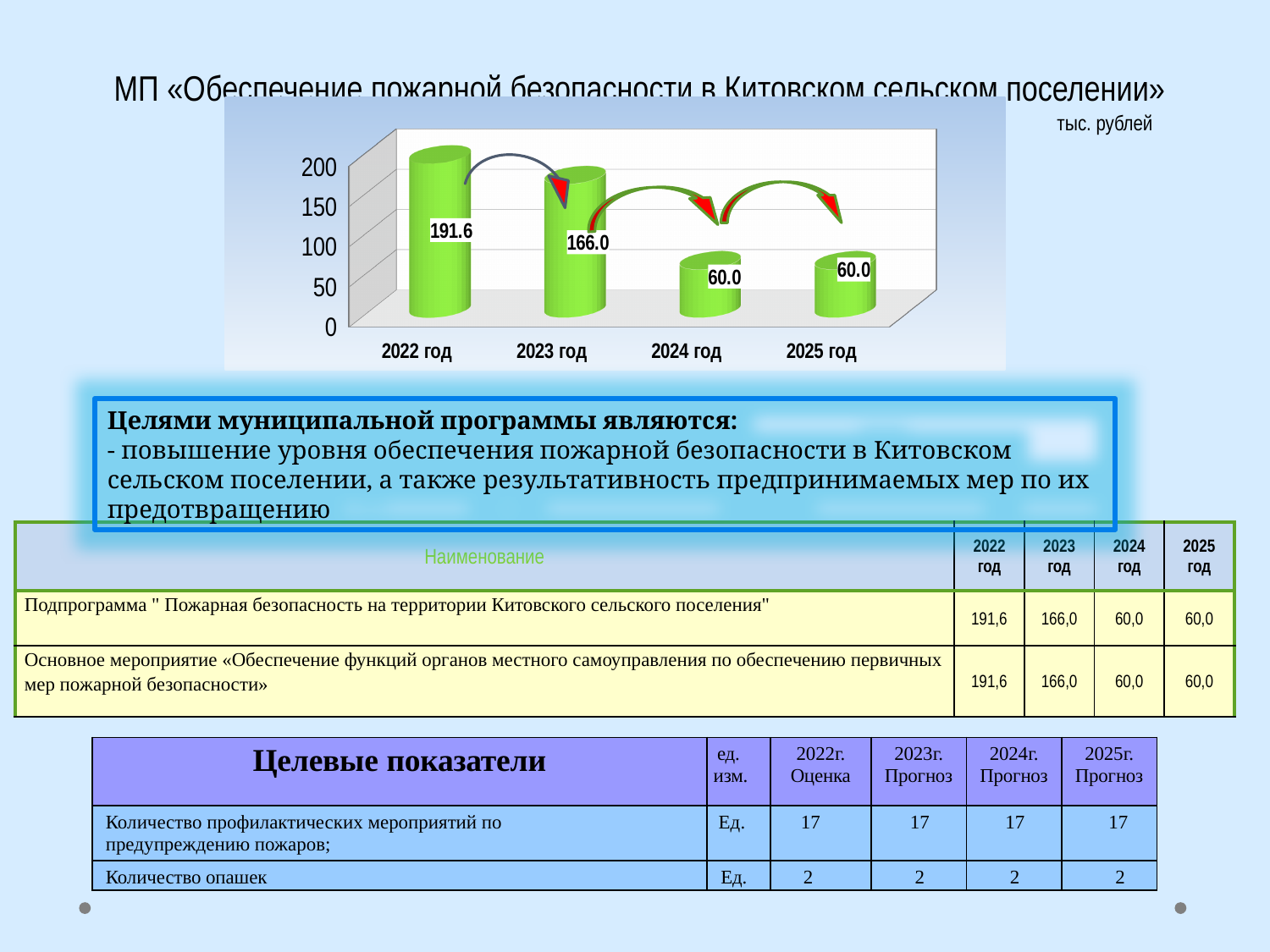
Do the values rise or fall from 2022 год to 2024 год? fall Which year has the highest value on the chart? 2022 год Which is larger, the value for 2022 год or the value for 2023 год? 2022 год What is the value shown for 2023 год on the chart? 166.0 What is the difference between the values for 2022 год and 2023 год? 25.6 What is the value shown for 2024 год on the chart? 60.0 What kind of chart is shown on the slide? bar chart What is the difference between the values for 2023 год and 2024 год? 106.0 What unit of measurement is indicated above the chart? тыс. рублей What is the value shown for 2022 год on the chart? 191.6 Is the value for 2024 год greater or less than 100? less How many years are shown on the x axis of the chart? 4